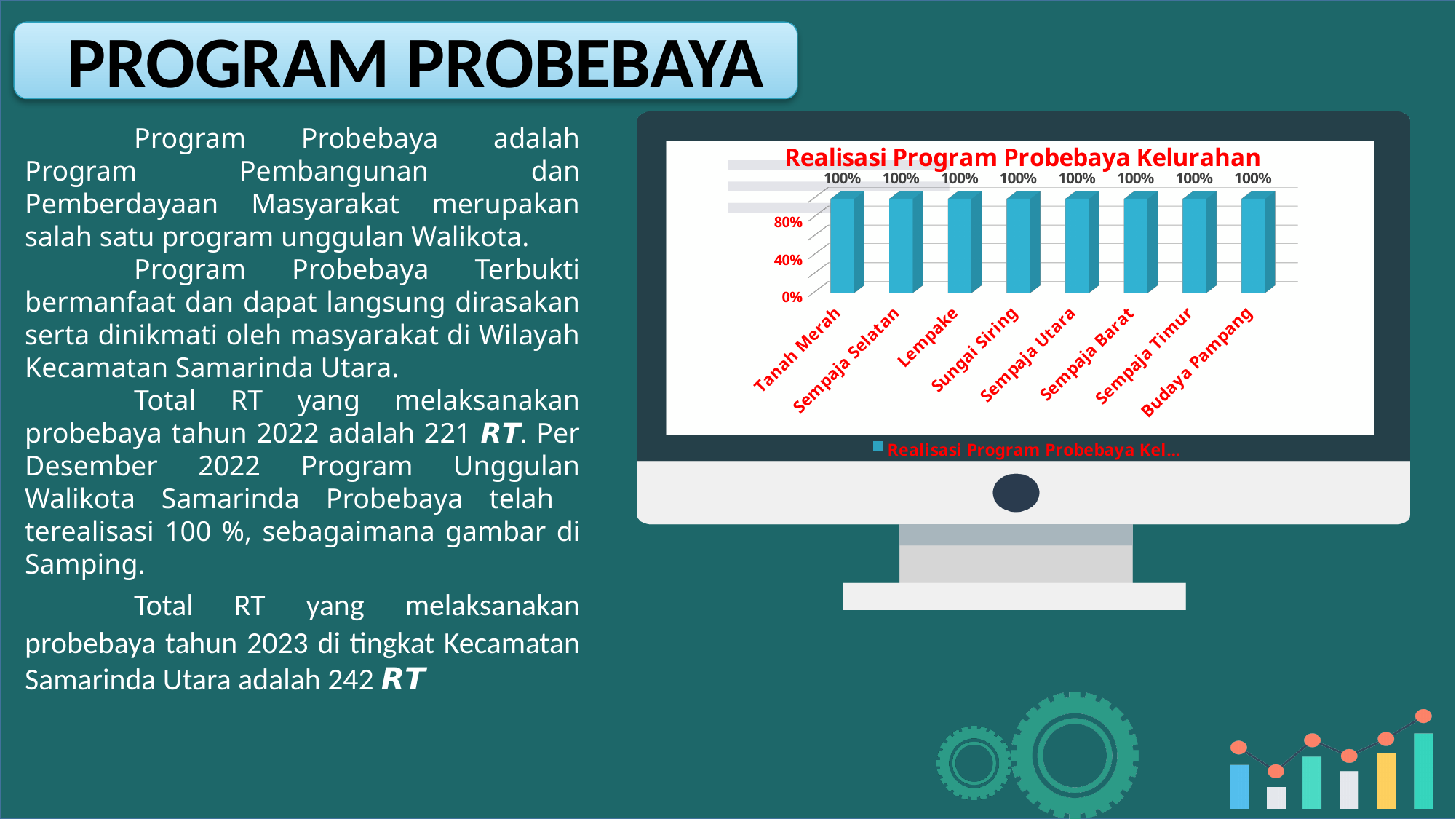
Which category is listed first on the x axis of the chart? Tanah Merah How many kelurahan categories are shown in the chart? 8 How many series does the chart legend list? 1 What is the value for Budaya Pampang in the chart? 100% Do the values rise, fall, or stay the same across the categories from Tanah Merah to Budaya Pampang? stay the same What is the value for Lempake in the chart? 100% What kind of chart is shown on the slide? bar chart What is the value for Sempaja Barat in the chart? 100% What is the title of the chart? Realisasi Program Probebaya Kelurahan Is the value for Sungai Siring greater or less than 80%? greater What is the value for Tanah Merah in the chart? 100% What is the difference between the values for Sempaja Selatan and Sempaja Timur? 0%